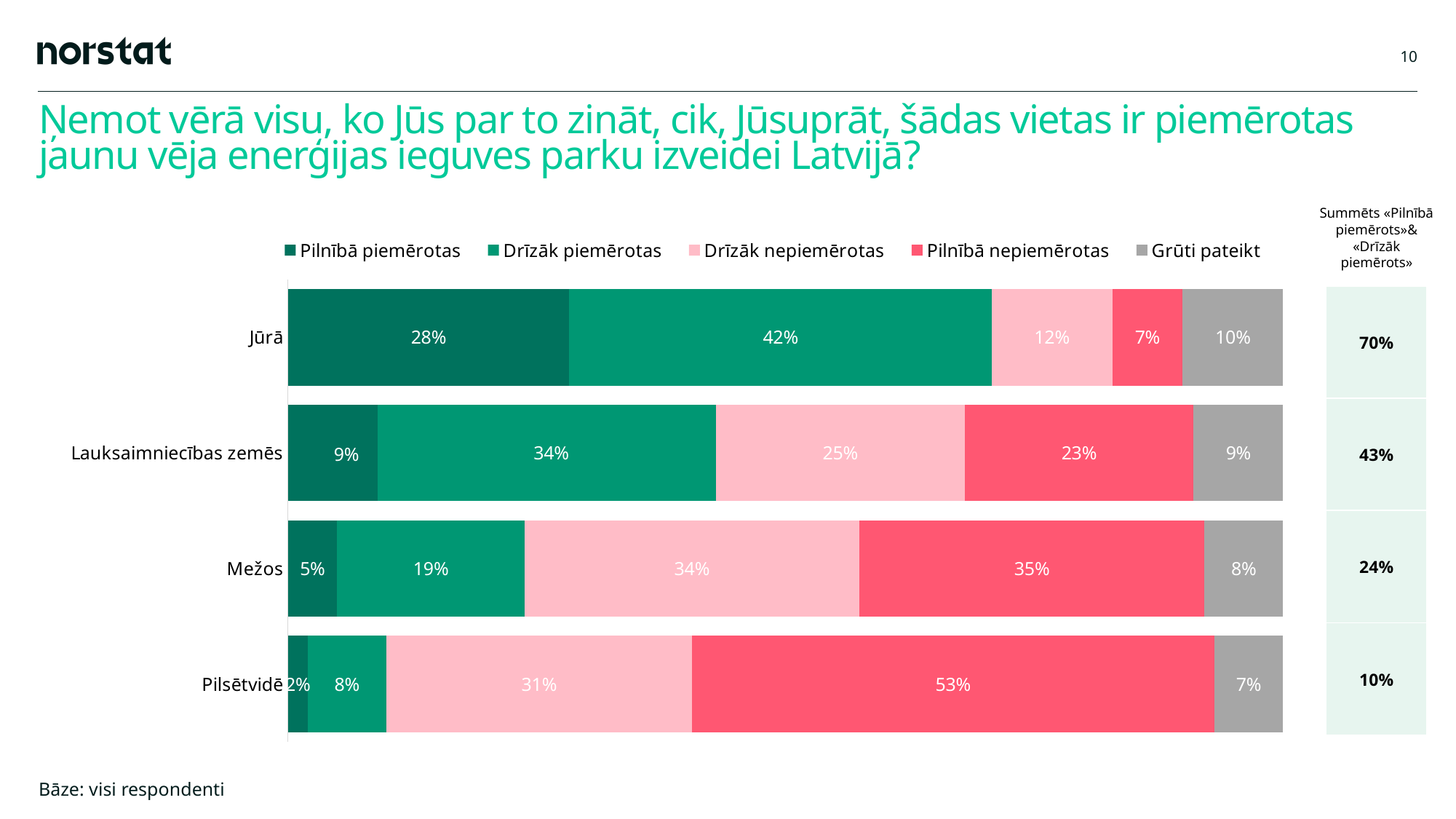
What is the "Grūti pateikt" value for Lauksaimniecības zemēs? 9% What kind of chart is shown on the slide? Stacked bar chart What is the summed "Pilnībā piemērots" & "Drīzāk piemērots" value shown for Mežos? 24% Which category has the highest "Drīzāk piemērotas" value? Jūrā What is the "Drīzāk nepiemērotas" value for Mežos? 34% How many series does the legend list? 5 How many categories are shown on the chart? 4 Which category has the lowest "Pilnībā piemērotas" value? Pilsētvidē Which is larger: the "Drīzāk piemērotas" value for Lauksaimniecības zemēs or for Mežos? Lauksaimniecības zemēs What is the difference between the "Pilnībā nepiemērotas" values for Pilsētvidē and Mežos? 18% What is the "Pilnībā nepiemērotas" value for Pilsētvidē? 53% What percentage of respondents answered "Pilnībā piemērotas" for Jūrā? 28%